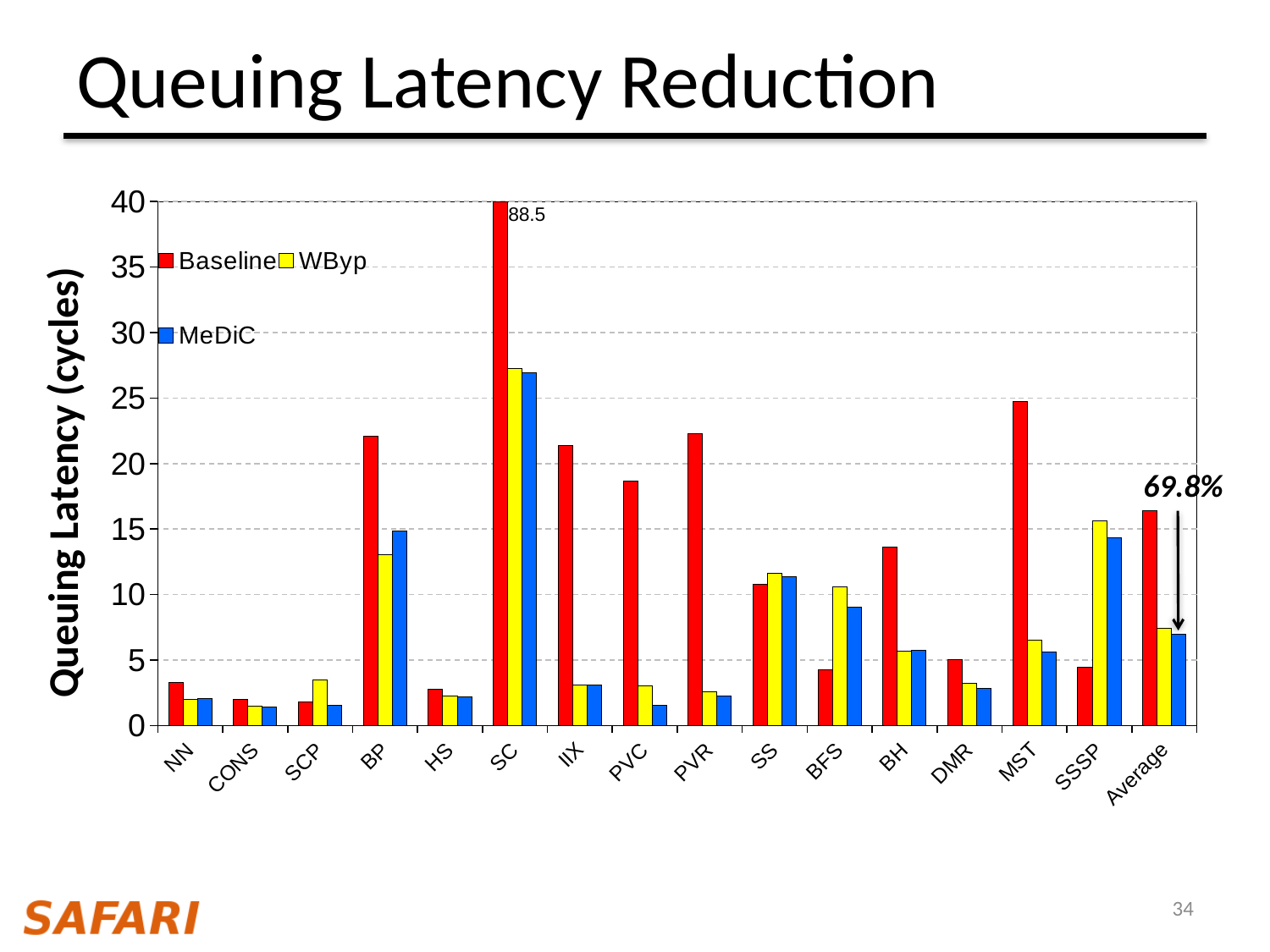
Is the Baseline value for MST greater or less than 20? greater How many series does the legend list? 3 Is the MeDiC value for SC greater or less than 25? greater For SSSP, which is larger: the Baseline value or the WByp value? WByp How many categories are shown along the x axis? 16 What percentage is annotated above the Average bars? 69.8% What is the Baseline queuing latency for SC? 88.5 For BP, which is larger: the Baseline value or the MeDiC value? Baseline Is the MeDiC value for PVR greater or less than 5? less Which category has the highest Baseline queuing latency? SC What kind of chart is shown on the slide? bar chart